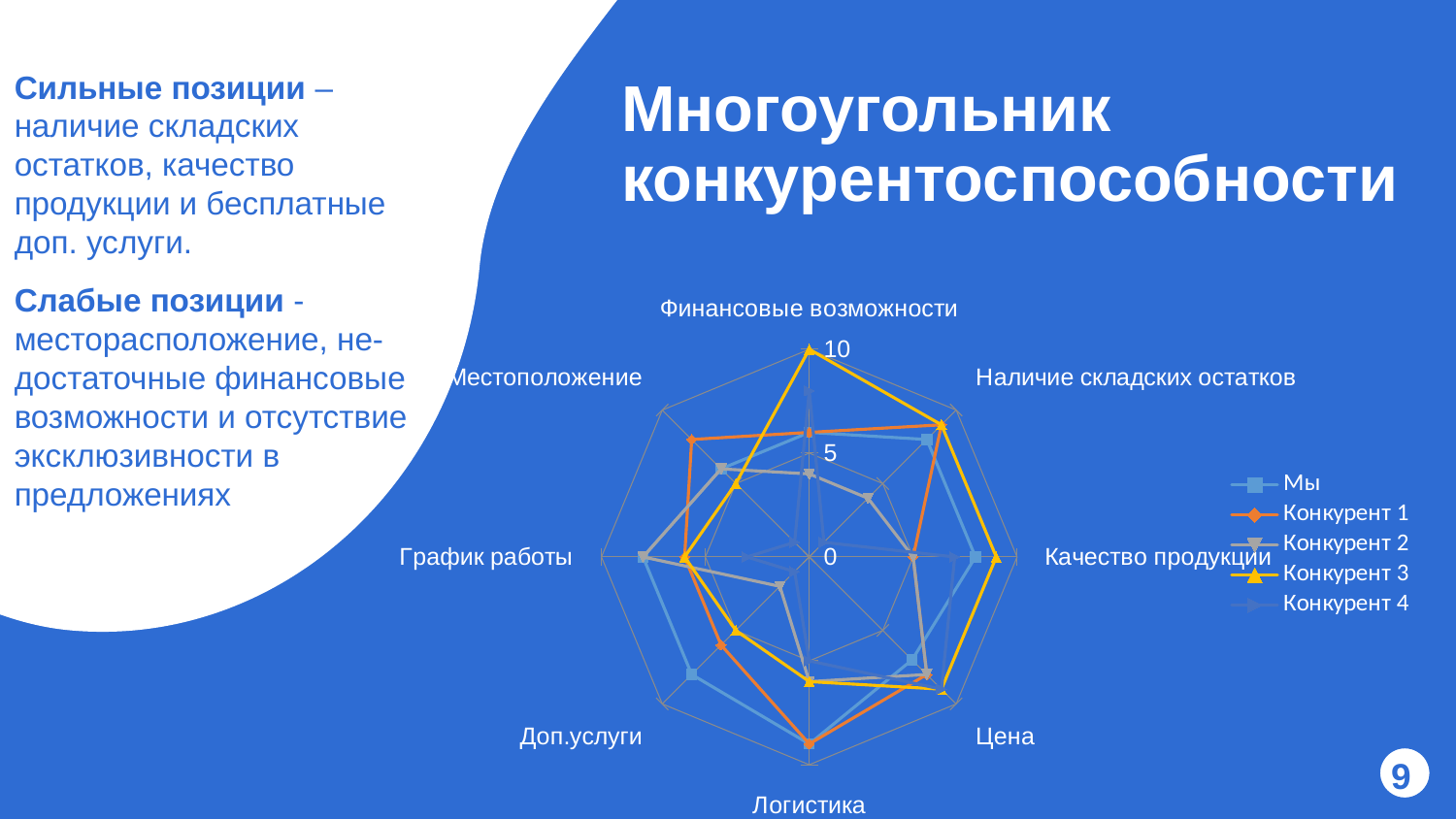
How many series does the chart legend list? 5 How many categories (axes) does the radar chart have? 8 Which series has the highest value on Финансовые возможности? Конкурент 3 Is the value for Мы on Доп.услуги greater or less than 5? greater Which series has the highest value on Логистика? Мы and Конкурент 1 (tied) On Качество продукции, which is larger: the value for Мы or for Конкурент 4? Мы Is the value for Конкурент 4 on Качество продукции greater or less than 5? greater What kind of chart is shown on the slide? Radar chart What is the value for Конкурент 3 on Финансовые возможности? 10 What is the title of the chart on the slide? Многоугольник конкурентоспособности